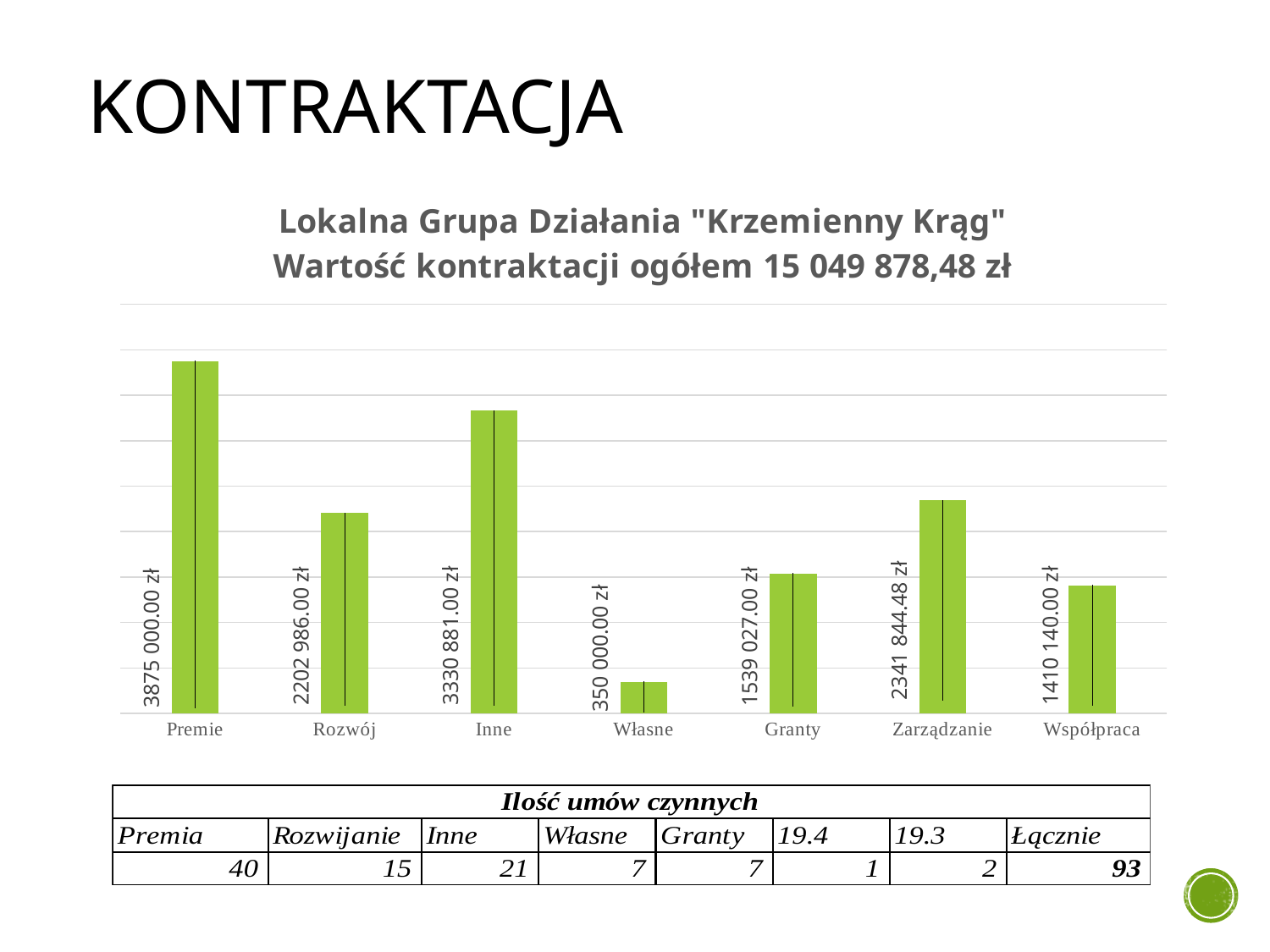
Which is larger, the value for Granty or the value for Zarządzanie? Zarządzanie How many categories are shown in the chart? 7 What is the value for Zarządzanie? 2341 844.48 zł What kind of chart is shown on the slide? Bar chart What is the difference between the values for Rozwój and Współpraca? 792 846.00 zł What is the value for Własne? 350 000.00 zł What total contract value is stated in the chart title? 15 049 878,48 zł What is the difference between the values for Premie and Inne? 544 119.00 zł Which category has the highest value? Premie What is the value for Premie? 3875 000.00 zł What is the value for Współpraca? 1410 140.00 zł Which category has the lowest value? Własne